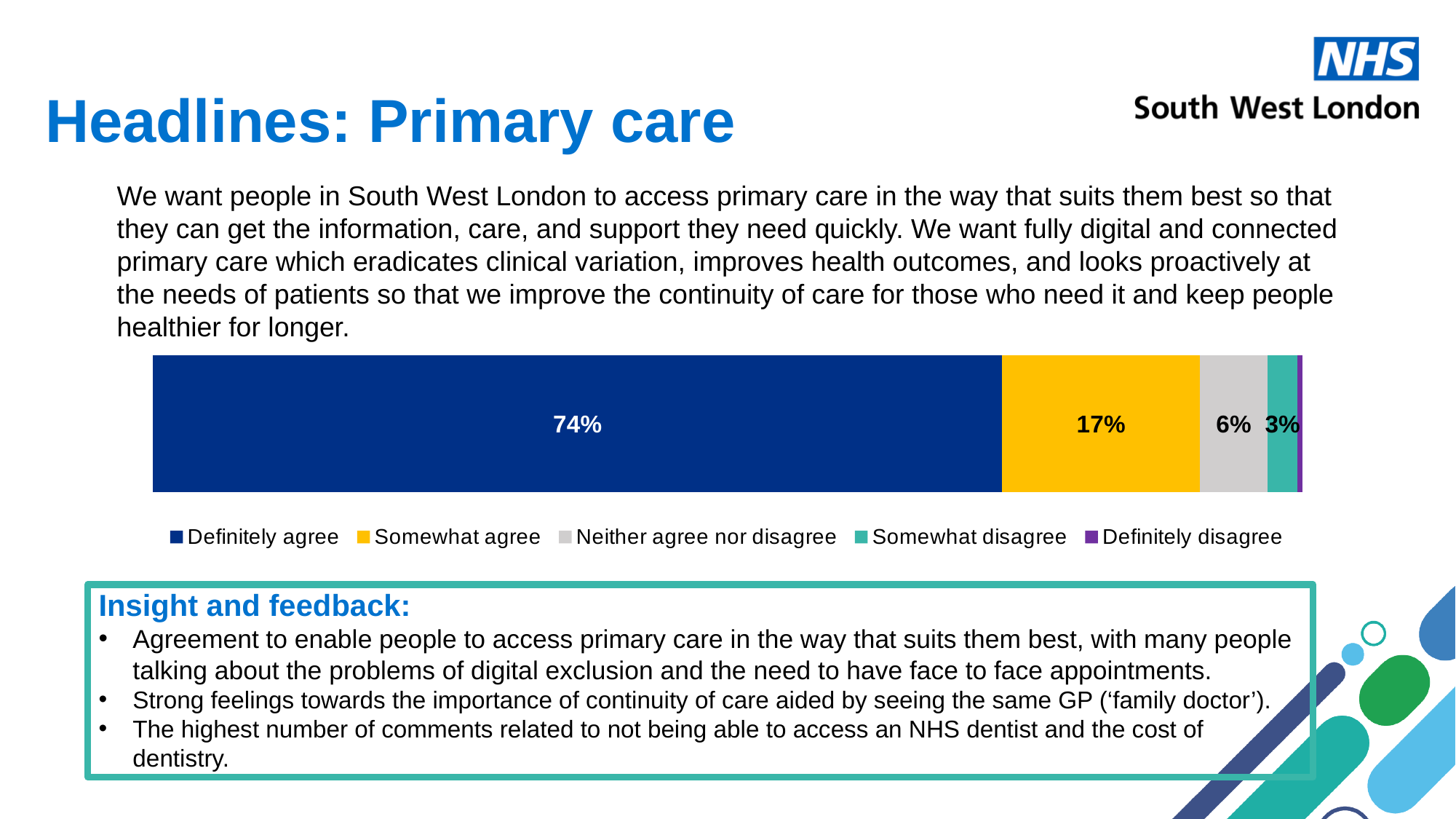
What percentage of respondents said they somewhat agree? 17% What percentage of respondents said they definitely agree? 74% What colour represents 'Somewhat agree' in the chart? Yellow What is the difference in percentage points between 'Definitely agree' and 'Somewhat agree'? 57 percentage points What percentage of respondents said they somewhat disagree? 3% Which response category has the smallest share of the bar? Definitely disagree What colour represents 'Definitely disagree' in the legend? Purple What kind of chart is shown on the slide? Stacked bar chart How many response categories does the legend list? 5 Which is larger, the share for 'Neither agree nor disagree' or the share for 'Somewhat disagree'? Neither agree nor disagree What percentage of respondents neither agree nor disagree? 6% Which response category has the largest share of the bar? Definitely agree